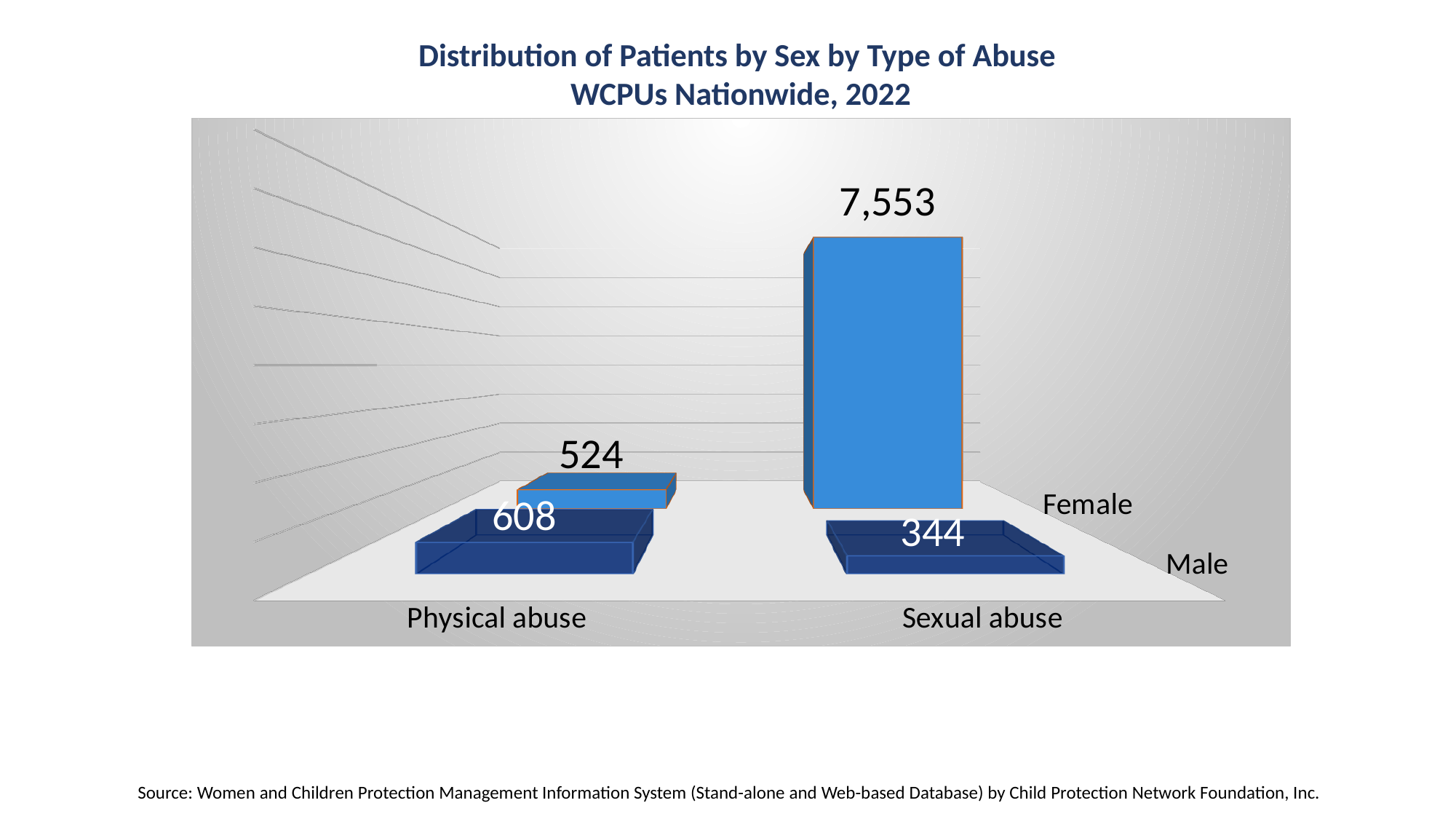
How many series (sexes) does the chart show? 2 What is the number of male patients for sexual abuse? 344 Which sex and type of abuse combination has the highest number of patients? Female, Sexual abuse What is the difference between the number of male and female patients for physical abuse? 84 Which sex and type of abuse combination has the lowest number of patients? Male, Sexual abuse For physical abuse, are there more male or female patients? Male What is the number of female patients for physical abuse? 524 What is the number of female patients for sexual abuse? 7,553 How many types of abuse are shown on the x axis? 2 What kind of chart is shown on the slide? Bar chart What is the difference between the number of female and male patients for sexual abuse? 7,209 What is the number of male patients for physical abuse? 608